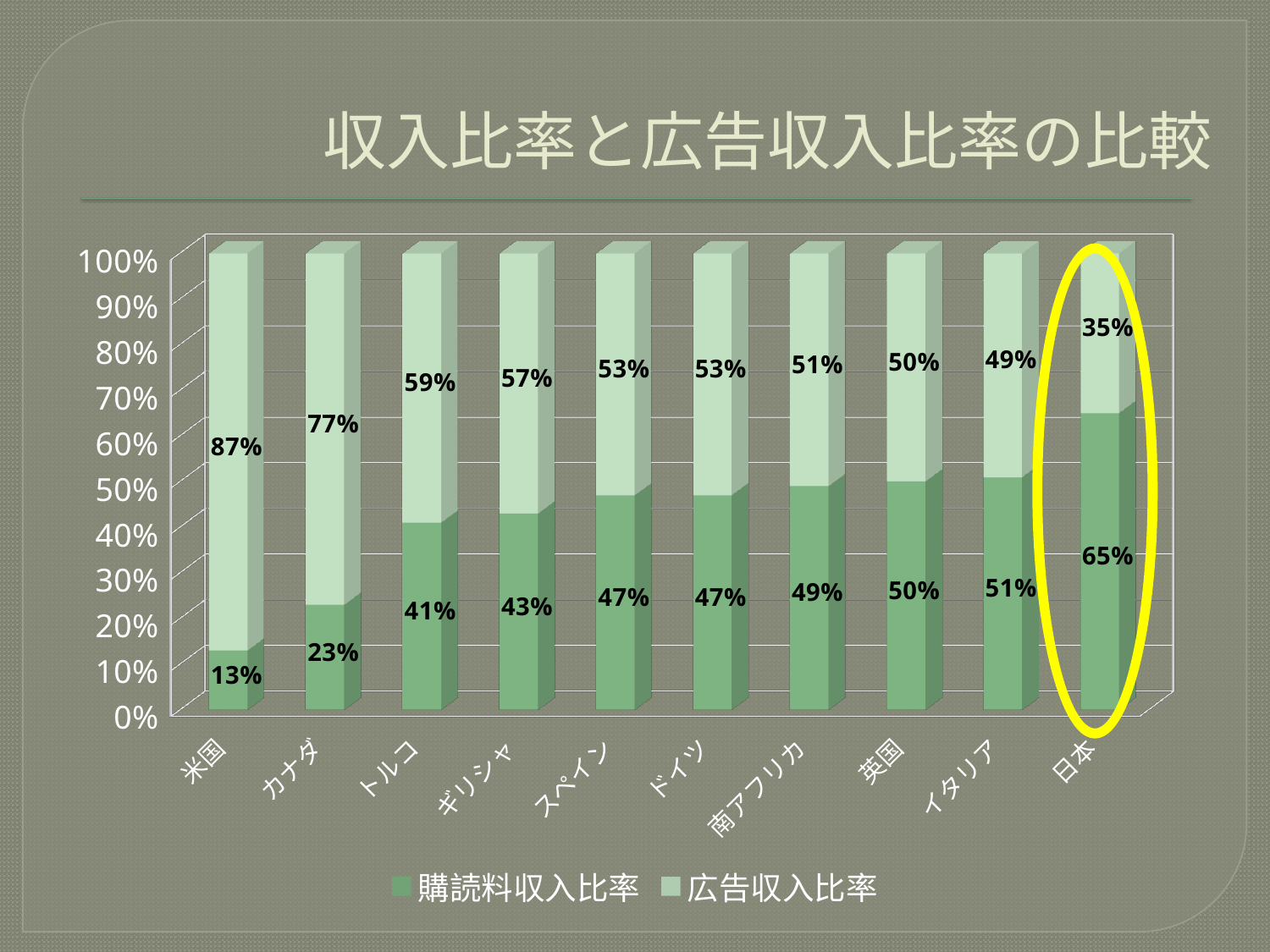
What is the 購読料収入比率 value for 米国? 13% What kind of chart is shown on the slide? Stacked bar chart What is the difference between the 広告収入比率 and the 購読料収入比率 for 米国? 74% Which country has the highest 購読料収入比率? 日本 How many series does the legend list? 2 Which is larger for ギリシャ, the 購読料収入比率 or the 広告収入比率? 広告収入比率 Which country has the highest 広告収入比率? 米国 How many countries are shown on the x axis? 10 Which country has the lowest 購読料収入比率? 米国 What is the 広告収入比率 value for カナダ? 77% What is the 購読料収入比率 value for 日本? 65% What is the 広告収入比率 value for トルコ? 59%